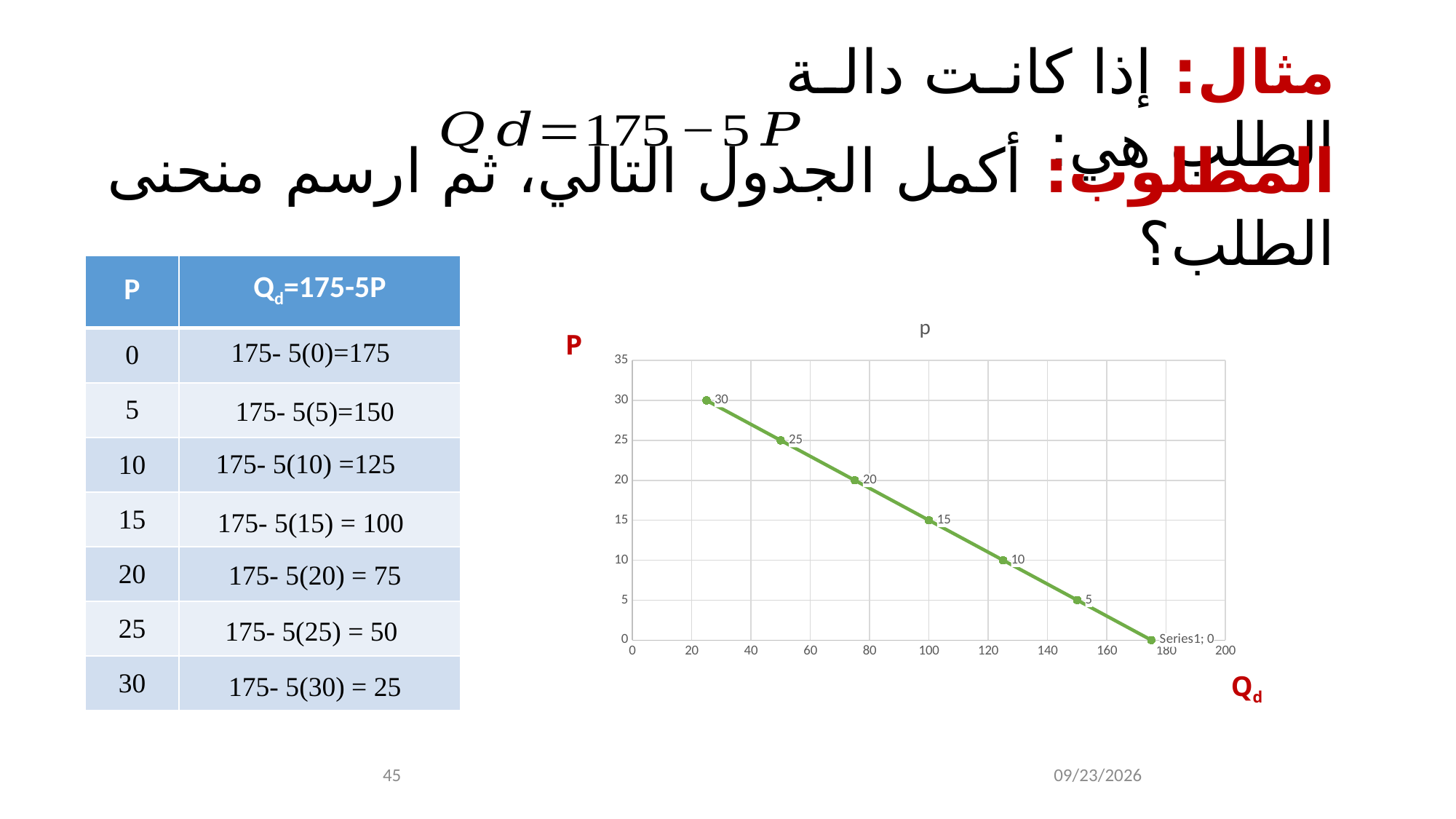
Which point has a higher P value: the one at Qd = 100 or the one near Qd = 150? the one at Qd = 100 What is the P value of the point plotted at Qd = 100? 15 As Qd increases along the x axis, does P rise or fall? fall How many data points are plotted on the chart? 7 What is the title shown above the chart? p What is the lowest P value labelled on the chart? 0 What is the difference between the P values of the two leftmost points on the chart? 5 Is the Qd value of the point labelled 5 greater or less than 140? greater What label is shown on the horizontal axis of the chart? Qd Is the Qd value of the point labelled 30 greater or less than 40? less What is the highest P value labelled on the chart? 30 What kind of chart is shown on the slide? line chart